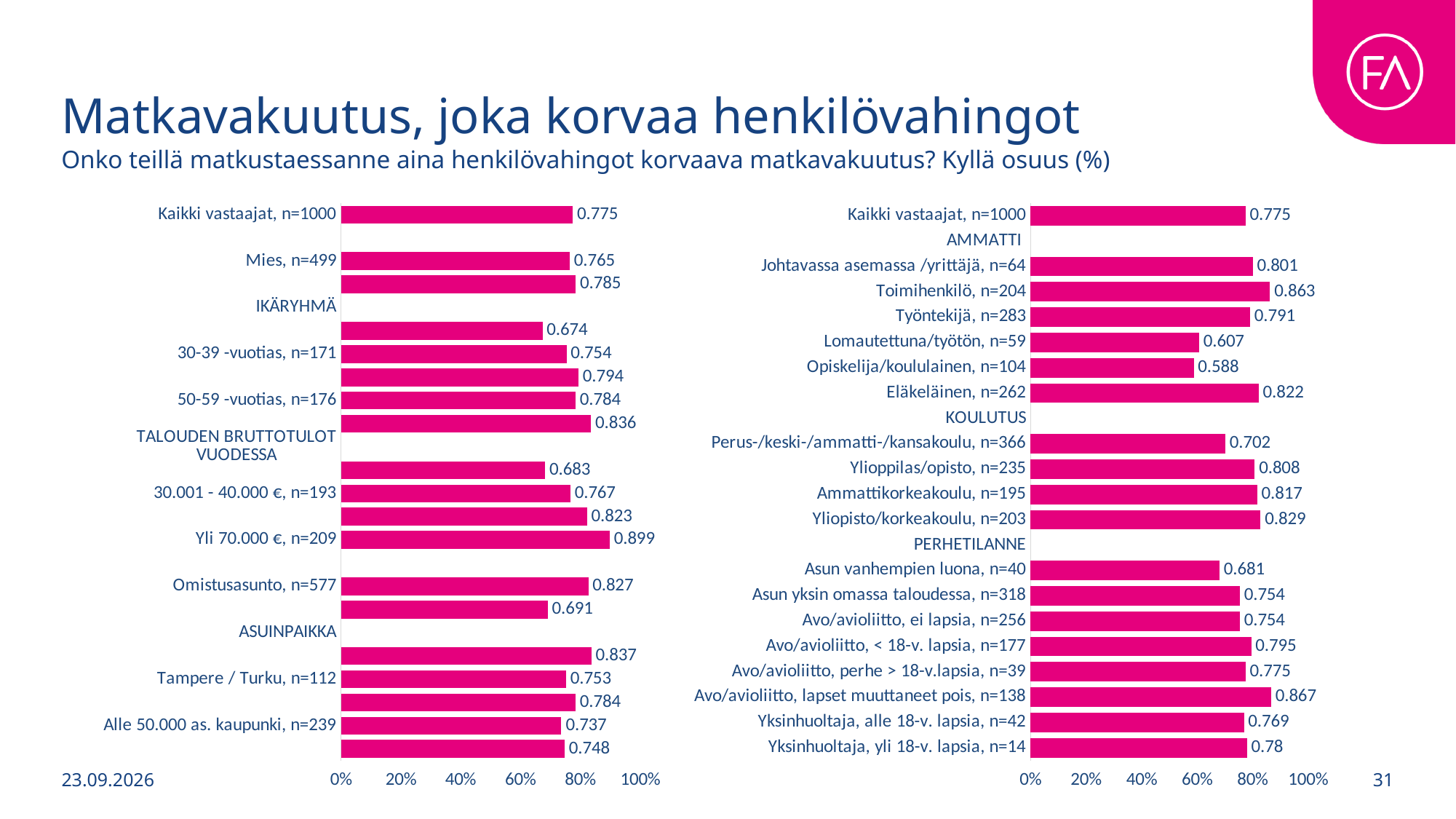
On the right-hand chart, what is the value for Toimihenkilö, n=204? 0.863 On the right-hand chart, is the value for Perus-/keski-/ammatti-/kansakoulu, n=366 greater or less than 80%? less On the right-hand chart, which category has the highest value? Avo/avioliitto, lapset muuttaneet pois, n=138 On the left-hand chart, what is the value for Yli 70.000 €, n=209? 0.899 On the right-hand chart, what is the value for Opiskelija/koululainen, n=104? 0.588 What type of chart is shown on the right-hand side of the slide? Bar chart On the right-hand chart, which category has the lowest value? Opiskelija/koululainen, n=104 On the right-hand chart, what is the difference between the values for Eläkeläinen, n=262 and Lomautettuna/työtön, n=59? 0.215 On the left-hand chart, which is larger: the value for Omistusasunto, n=577 or the value for Mies, n=499? Omistusasunto, n=577 What is the value for Kaikki vastaajat, n=1000 on the right-hand chart? 0.775 On the left-hand chart, what is the value for Tampere / Turku, n=112? 0.753 On the left-hand chart, what is the difference between the values for Kaikki vastaajat, n=1000 and Alle 50.000 as. kaupunki, n=239? 0.038